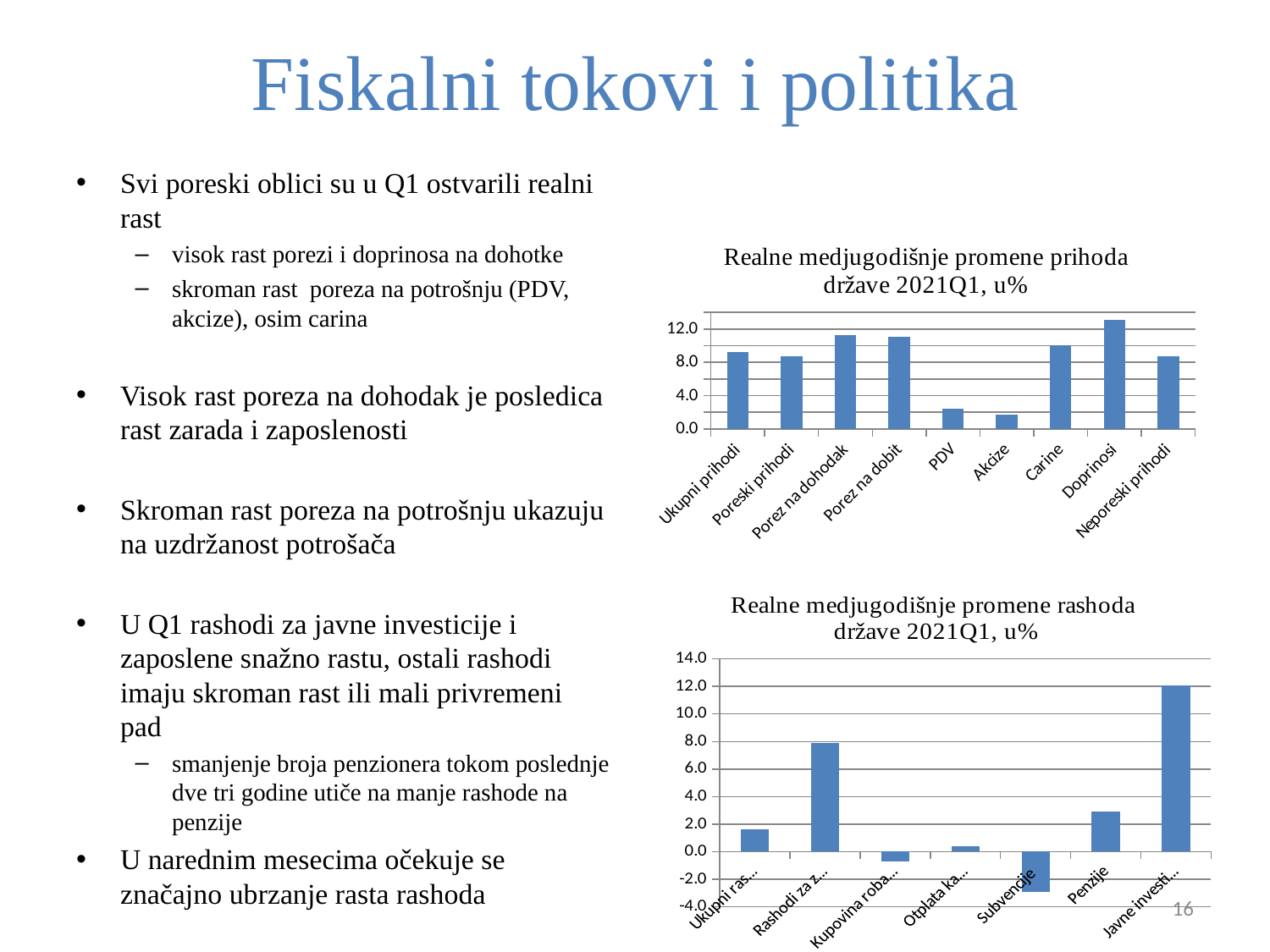
In the top chart, 'Realne medjugodišnje promene prihoda države 2021Q1, u%', is the value for PDV greater or less than 4.0? less In the bottom chart, 'Realne medjugodišnje promene rashoda države 2021Q1, u%', which is larger: Penzije or Subvencije? Penzije What kind of chart is the bottom chart, 'Realne medjugodišnje promene rashoda države 2021Q1, u%'? bar chart In the top chart, 'Realne medjugodišnje promene prihoda države 2021Q1, u%', which category has the highest value? Doprinosi What kind of chart is the top chart, 'Realne medjugodišnje promene prihoda države 2021Q1, u%'? bar chart In the top chart, 'Realne medjugodišnje promene prihoda države 2021Q1, u%', which is larger: Porez na dohodak or PDV? Porez na dohodak In the bottom chart, 'Realne medjugodišnje promene rashoda države 2021Q1, u%', is the value for Penzije greater or less than 4.0? less In the bottom chart, 'Realne medjugodišnje promene rashoda države 2021Q1, u%', which category has the lowest value? Subvencije In the top chart, 'Realne medjugodišnje promene prihoda države 2021Q1, u%', is the value for Doprinosi greater or less than 12.0? greater How many categories are shown in the top chart, 'Realne medjugodišnje promene prihoda države 2021Q1, u%'? 9 How many bars are shown in the bottom chart, 'Realne medjugodišnje promene rashoda države 2021Q1, u%'? 7 In the top chart, 'Realne medjugodišnje promene prihoda države 2021Q1, u%', which category has the lowest value? Akcize